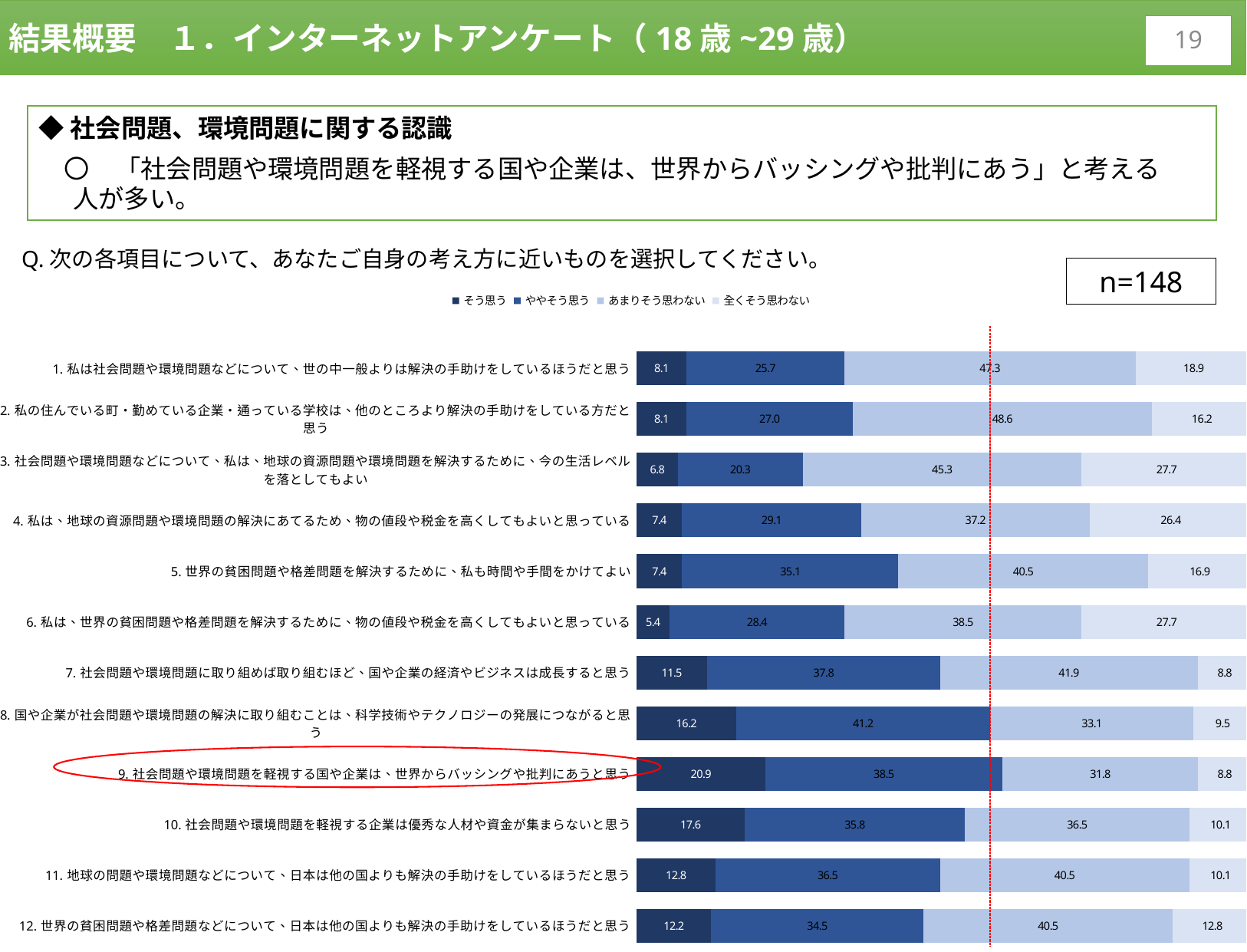
Which item has the highest そう思う value? 9. 社会問題や環境問題を軽視する国や企業は、世界からバッシングや批判にあうと思う What is the difference between the そう思う value for item 9 (20.9) and item 1 (8.1)? 12.8 How many statement items (categories) are plotted in the chart? 12 Which item has the lowest そう思う value? 6. 私は、世界の貧困問題や格差問題を解決するために、物の値段や税金を高くしてもよいと思っている What is the そう思う value for item 9 (社会問題や環境問題を軽視する国や企業は、世界からバッシングや批判にあうと思う)? 20.9 What is the あまりそう思わない value for item 2 (私の住んでいる町・勤めている企業・通っている学校は、他のところより解決の手助けをしている方だと思う)? 48.6 How many series does the chart legend list? 4 What is the 全くそう思わない value for item 1 (私は社会問題や環境問題などについて、世の中一般よりは解決の手助けをしているほうだと思う)? 18.9 What kind of chart is shown on the slide? Stacked bar chart Which has the larger ややそう思う value: item 8 (国や企業が社会問題や環境問題の解決に取り組むことは、科学技術やテクノロジーの発展につながると思う) or item 9 (社会問題や環境問題を軽視する国や企業は、世界からバッシングや批判にあうと思う)? Item 8 What is the first entry in the chart legend? そう思う What is the sample size (n) shown on the slide? n=148